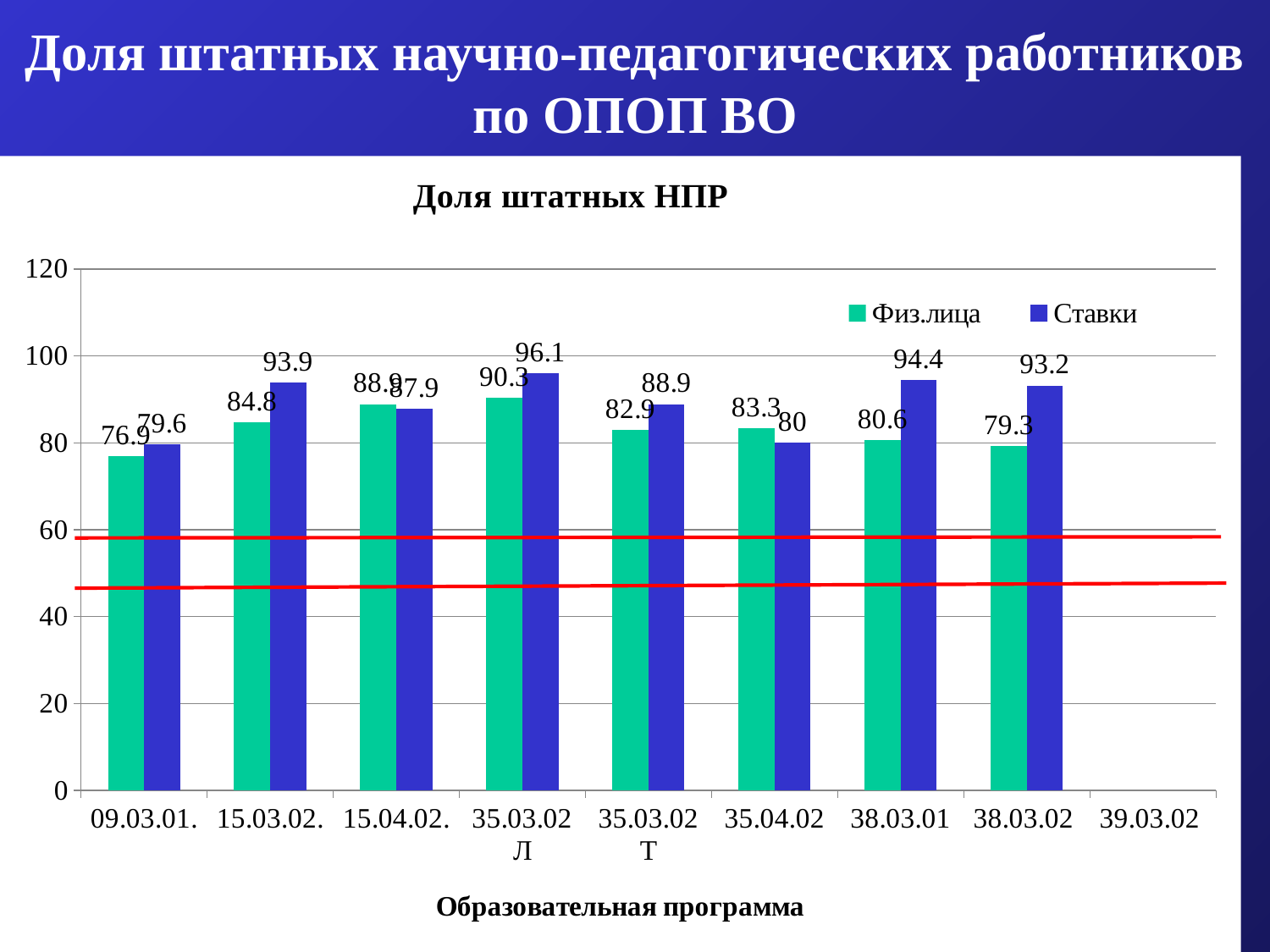
Which programme has the lowest Физ.лица value? 09.03.01. What is the difference between Ставки and Физ.лица for 38.03.01? 13.8 What is the value of Ставки for 35.03.02 Л? 96.1 Is the Ставки value for 35.03.02 Л greater or less than 100? less What is the value of Физ.лица for 09.03.01.? 76.9 For 35.04.02, which is larger: Физ.лица or Ставки? Физ.лица What is the title of the x axis? Образовательная программа How many series does the legend list? 2 What kind of chart is shown on the slide? bar chart What is the value of Ставки for 38.03.01? 94.4 What is the value of Физ.лица for 35.04.02? 83.3 Which programme has the highest Ставки value? 35.03.02 Л